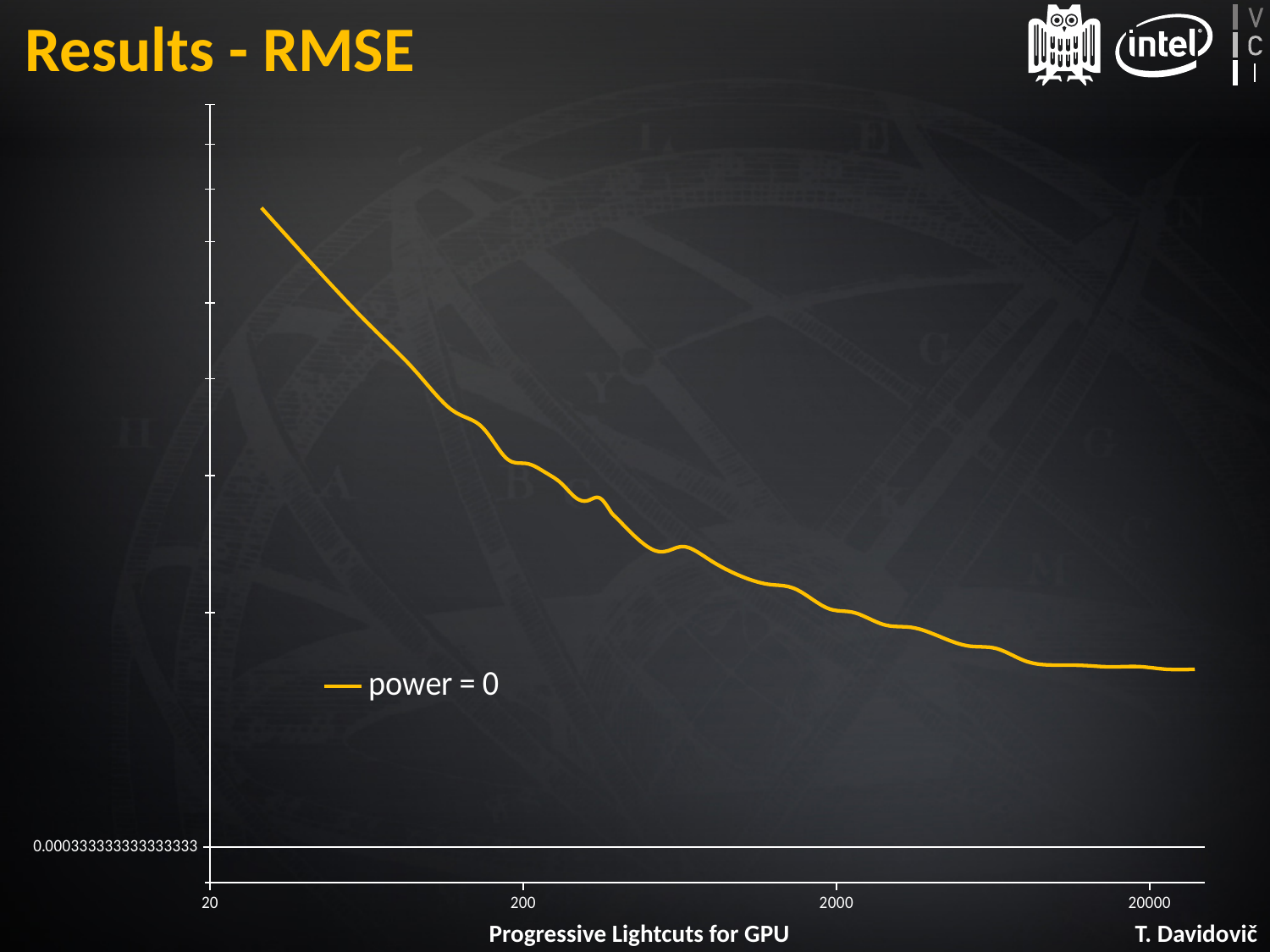
Is the plotted line higher at x = 2000 or at x = 20000? 2000 What kind of chart is shown on the slide? line chart What is the title of the slide containing the chart? Results - RMSE Is the plotted line higher at x = 200 or at x = 2000? 200 How many tick labels are printed along the x axis? 4 How many series does the legend list? 1 Do the values of the plotted line rise or fall as you move along the x axis from 20 to 20000? fall What is the name of the series shown in the legend? power = 0